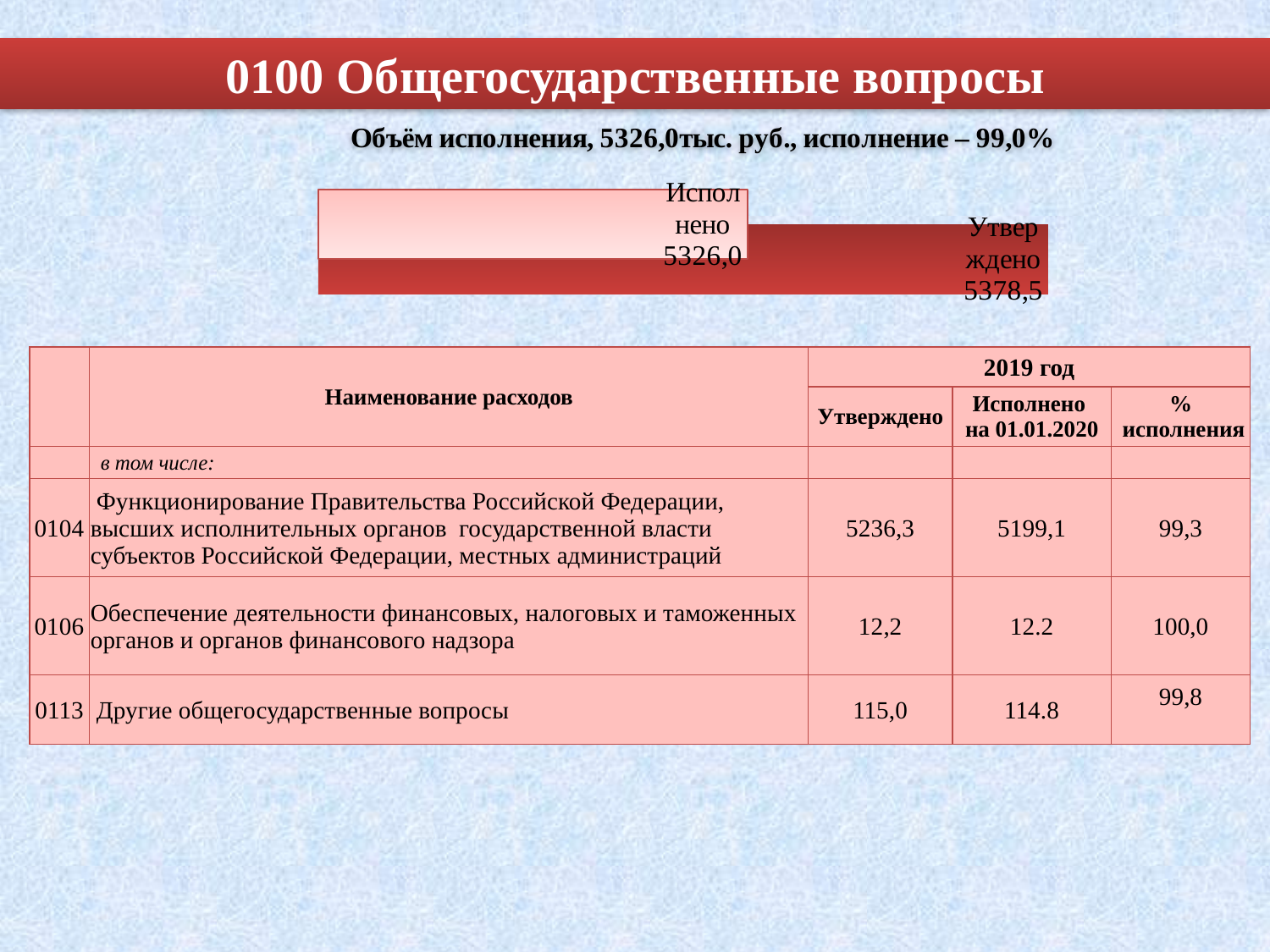
What kind of chart is shown on the slide? Bar chart Which bar in the chart has the lowest value? Исполнено Which bar in the chart is drawn in the darker red colour? Утверждено What is the value of the "Исполнено" bar in the chart? 5326,0 Are the bars in the chart oriented horizontally or vertically? Horizontally Which bar in the chart has the highest value? Утверждено What is the difference between the "Утверждено" and "Исполнено" values in the chart? 52,5 How many bars are plotted in the chart? 2 Which bar in the chart has the higher value, "Исполнено" or "Утверждено"? Утверждено What is the value of the "Утверждено" bar in the chart? 5378,5